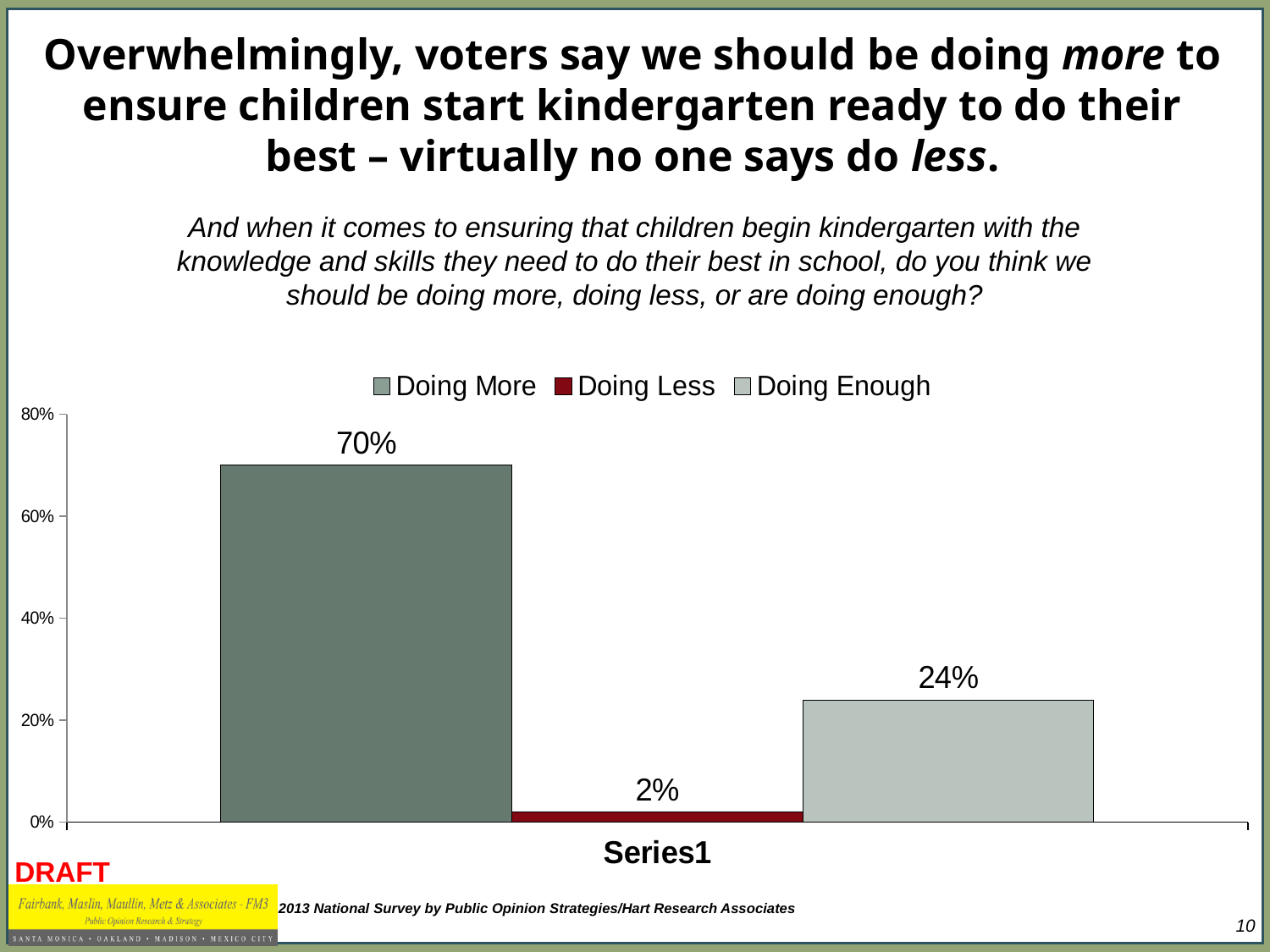
Which response has the lowest percentage? Doing Less Which is larger, Doing Enough or Doing Less? Doing Enough What percentage of voters say we should be doing less? 2% How many series does the legend list? 3 What is the difference between the Doing More and Doing Enough percentages? 46% Which response has the highest percentage? Doing More Is the value for Doing More greater or less than 60%? greater What colour is the Doing Less bar? Dark red What is the difference between the Doing Enough and Doing Less percentages? 22% What percentage of voters say we are doing enough? 24% What percentage of voters say we should be doing more? 70% What kind of chart is shown on the slide? Bar chart